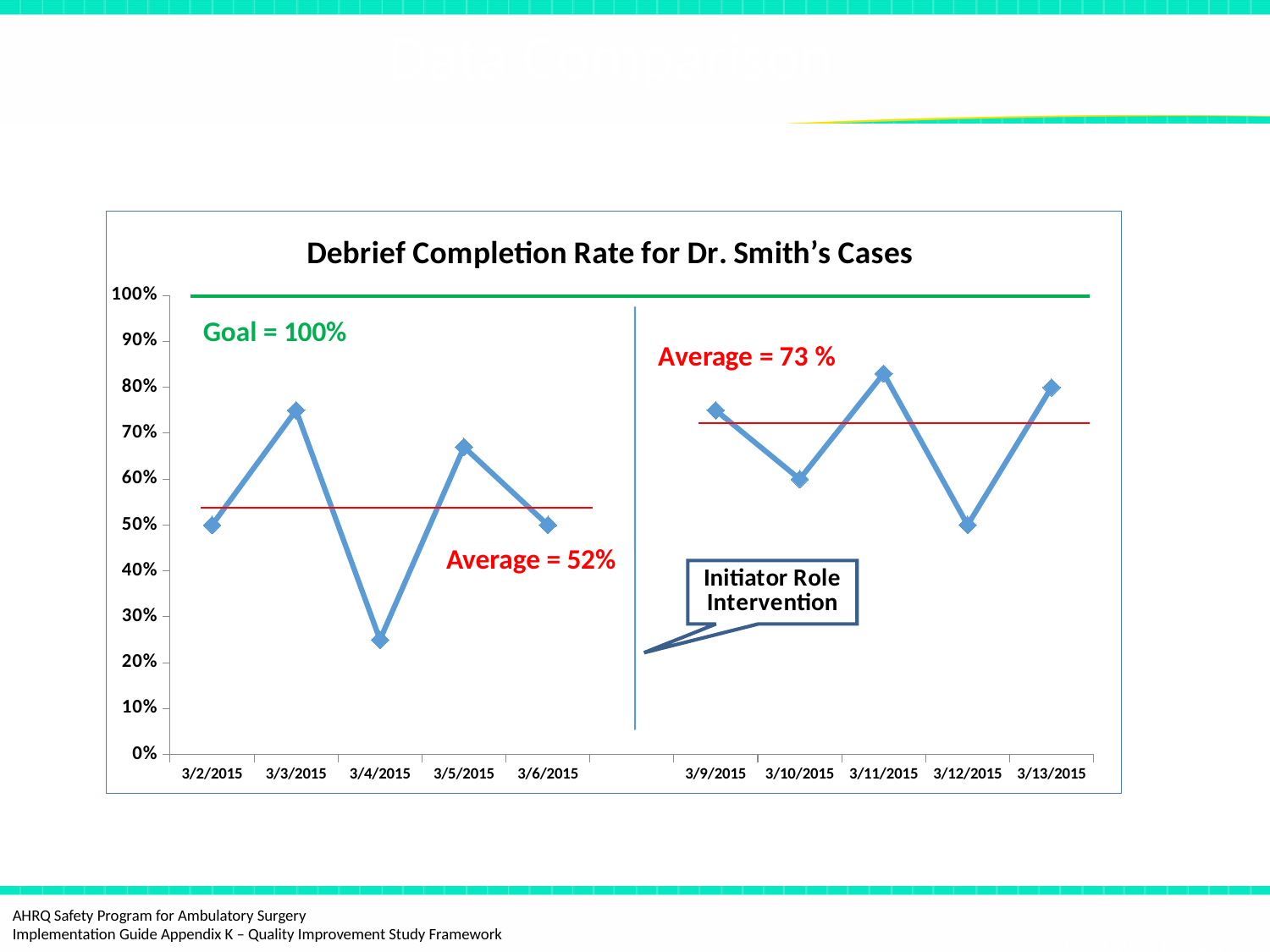
Which date has the lowest debrief completion rate? 3/4/2015 How many dates are plotted on the x axis of the chart? 10 What is the debrief completion rate on 3/10/2015? 60% What is the goal value shown on the chart? 100% What is the debrief completion rate on 3/13/2015? 80% What is the average debrief completion rate shown for the period before the Initiator Role Intervention? 52% What intervention is labeled in the callout box on the chart? Initiator Role Intervention What is the title of the chart? Debrief Completion Rate for Dr. Smith's Cases Is the value for 3/4/2015 greater or less than 30%? less Which is larger, the value for 3/3/2015 or the value for 3/5/2015? 3/3/2015 What type of chart is shown on the slide? line chart What is the average debrief completion rate shown for the period after the Initiator Role Intervention? 73 %